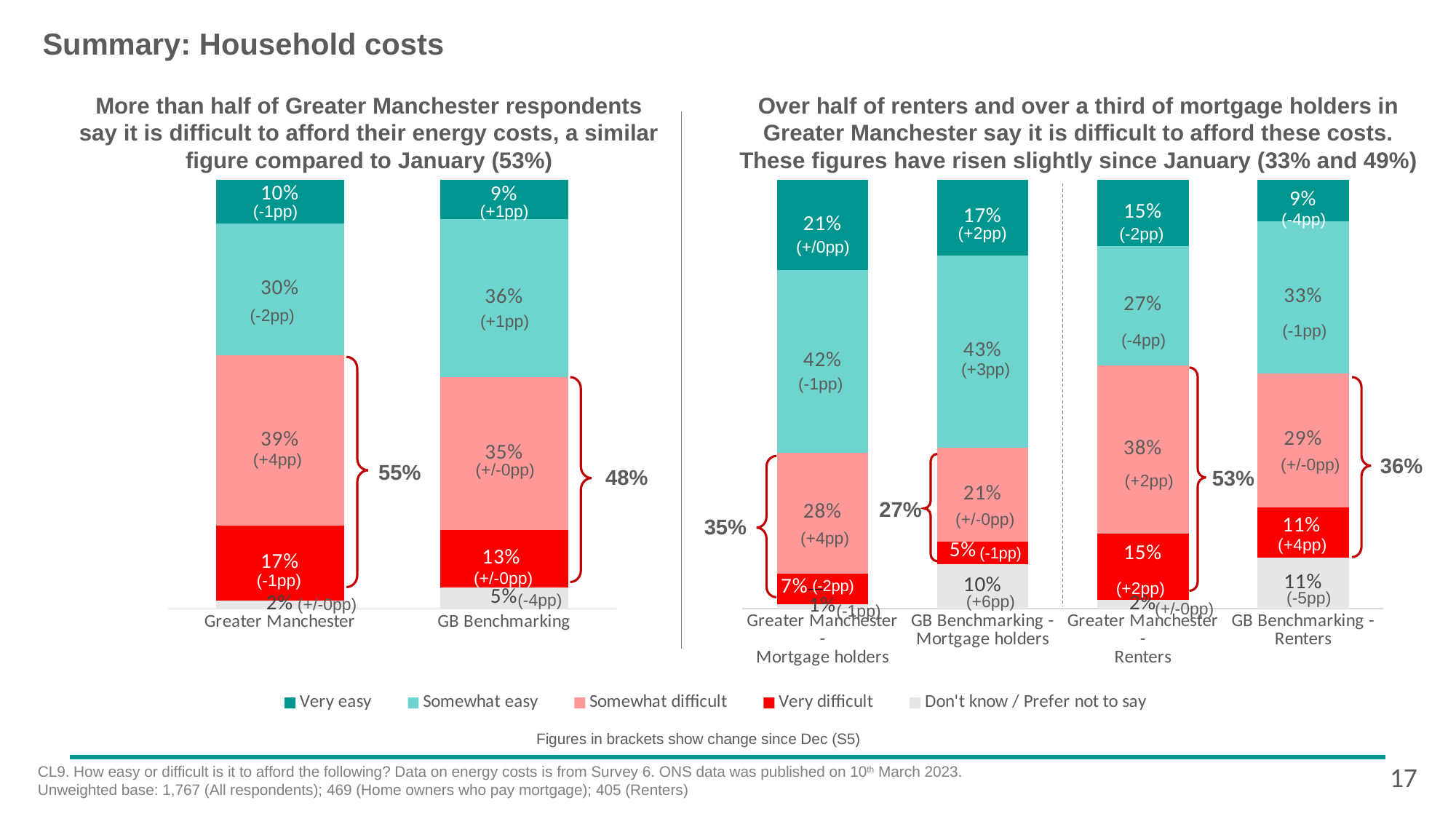
How many series does the legend list? 5 In the right chart, is the 'Somewhat easy' value larger for GB Benchmarking mortgage holders or Greater Manchester renters? GB Benchmarking - Mortgage holders What type of chart is used on this slide? Stacked bar chart In the right chart, what combined difficulty share is shown by the bracket for GB Benchmarking renters? 36% In the right chart, what is the 'Somewhat difficult' value for Greater Manchester renters? 38% In the right chart, which of the four bars has the highest 'Very difficult' value? Greater Manchester - Renters How many bars are shown in the right chart? 4 In the left chart, what is the difference between the 'Somewhat easy' values for GB Benchmarking and Greater Manchester? 6 percentage points In the left chart, what combined share of Greater Manchester respondents find it difficult (somewhat or very) to afford energy costs, as shown by the bracket? 55% In the right chart, what is the 'Very easy' value for Greater Manchester mortgage holders? 21% In the left chart, what percentage of Greater Manchester respondents say it is somewhat difficult to afford their energy costs? 39% In the left chart, what is the 'Very difficult' value for GB Benchmarking? 13%